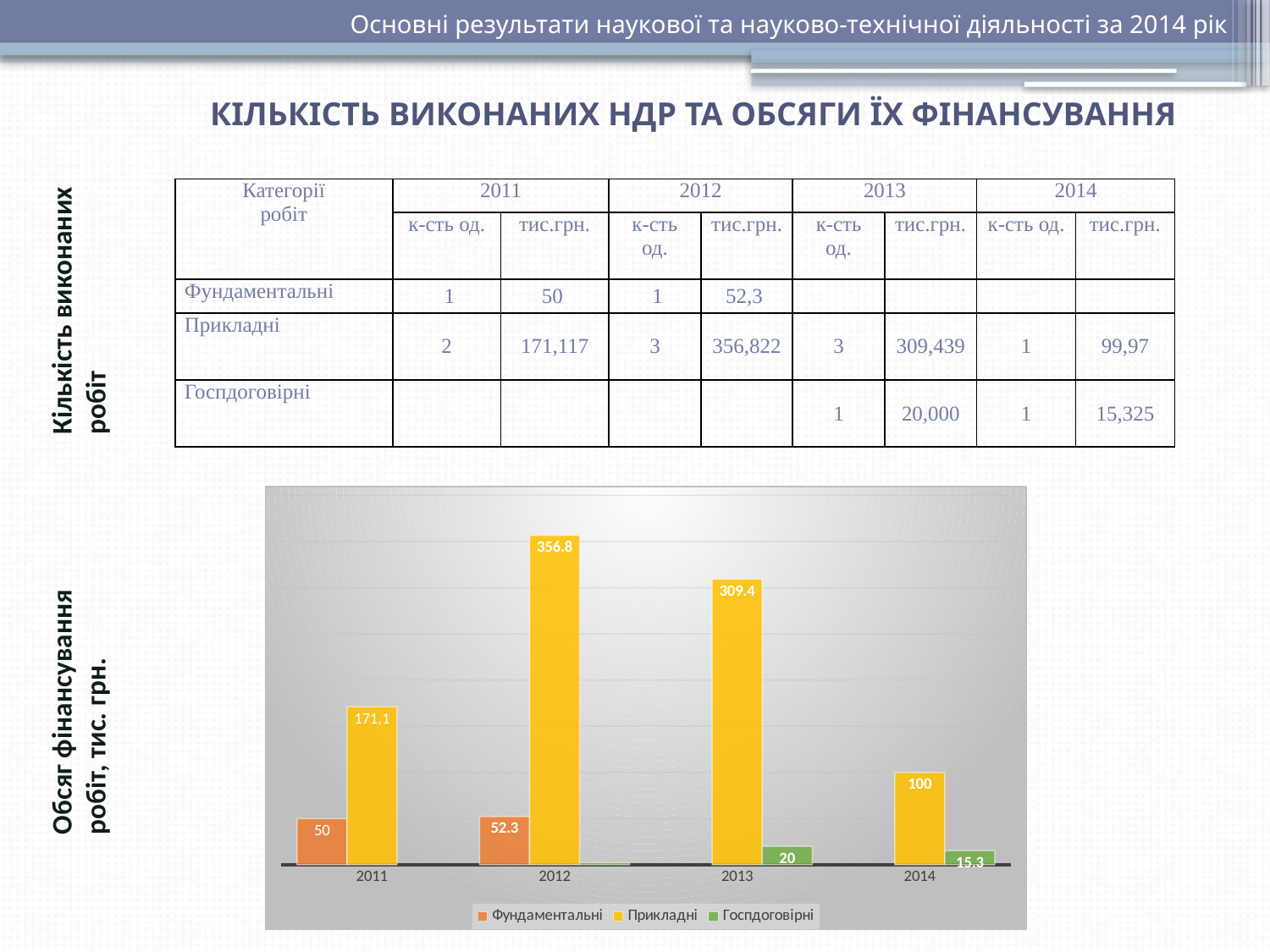
What is the difference between the Прикладні values for 2012 and 2013? 47.4 How many series does the chart legend list? 3 In which year is the value for Прикладні the highest? 2012 In which year is the value for Прикладні the lowest? 2014 What is the value for Госпдоговірні in 2014? 15.3 What is the value for Фундаментальні in 2011? 50 How many years are shown on the x axis of the chart? 4 What is the value for Прикладні in 2011? 171,1 What is the difference between the Прикладні and Госпдоговірні values in 2014? 84.7 Which is larger: the Госпдоговірні value in 2013 or in 2014? 2013 What kind of chart is shown on the slide? bar chart What is the value for Прикладні in 2012? 356.8